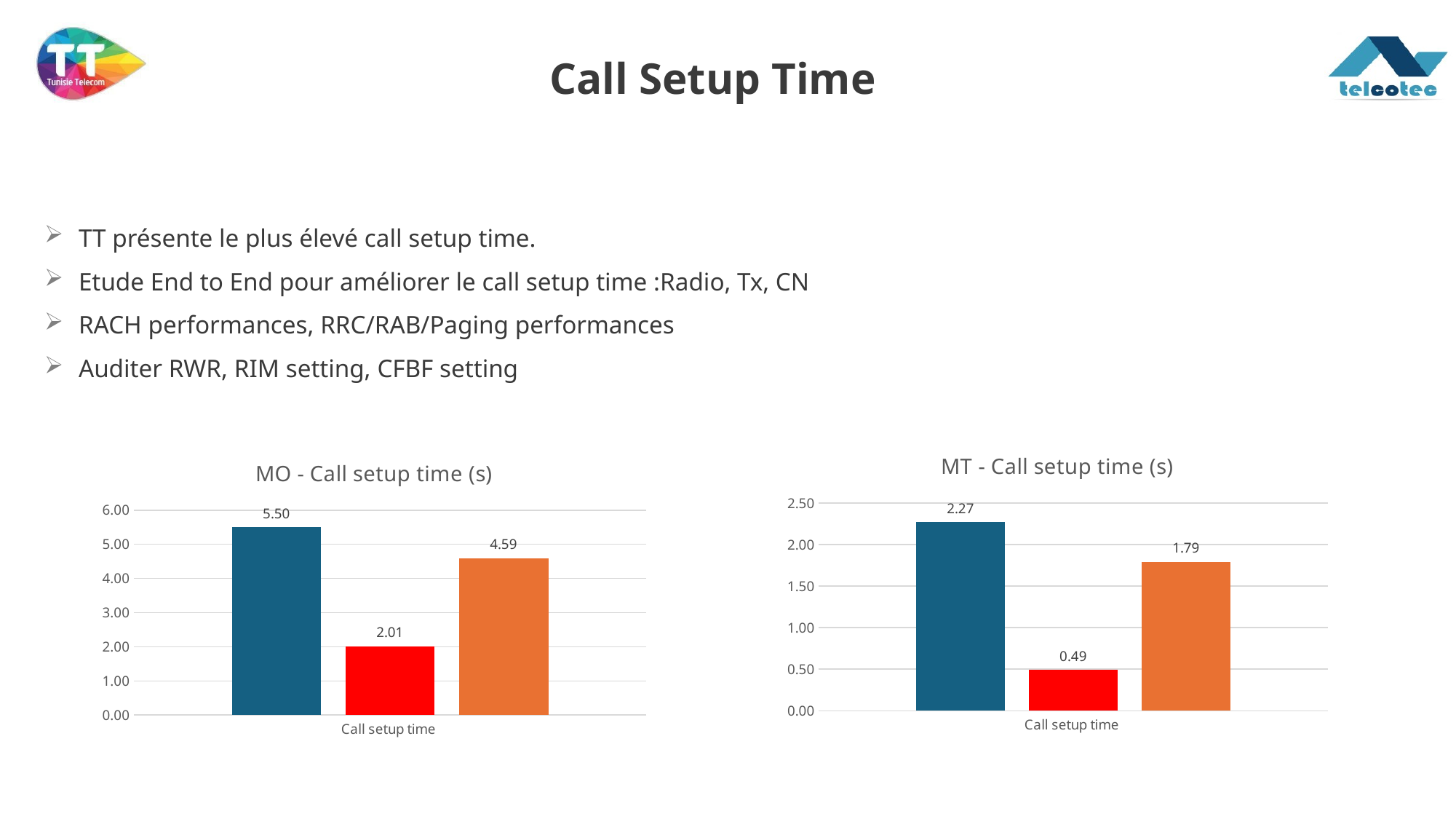
In the "MT - Call setup time (s)" chart, what is the value of the orange bar? 1.79 What is the x-axis category label shown under the bars in the "MT - Call setup time (s)" chart? Call setup time In the "MT - Call setup time (s)" chart, what is the value of the tallest bar? 2.27 How many bars are plotted in the "MO - Call setup time (s)" chart? 3 In the "MT - Call setup time (s)" chart, is the blue bar or the orange bar larger? the blue bar In the "MT - Call setup time (s)" chart, what is the difference between the blue bar (2.27) and the red bar (0.49)? 1.78 In the "MO - Call setup time (s)" chart, what is the value of the tallest bar? 5.50 What type of chart is the "MO - Call setup time (s)" chart? bar chart In the "MO - Call setup time (s)" chart, what is the difference between the blue bar (5.50) and the orange bar (4.59)? 0.91 In the "MO - Call setup time (s)" chart, what is the value of the shortest bar? 2.01 In the "MO - Call setup time (s)" chart, what is the value shown on the orange bar? 4.59 In the "MT - Call setup time (s)" chart, what is the value of the red bar? 0.49